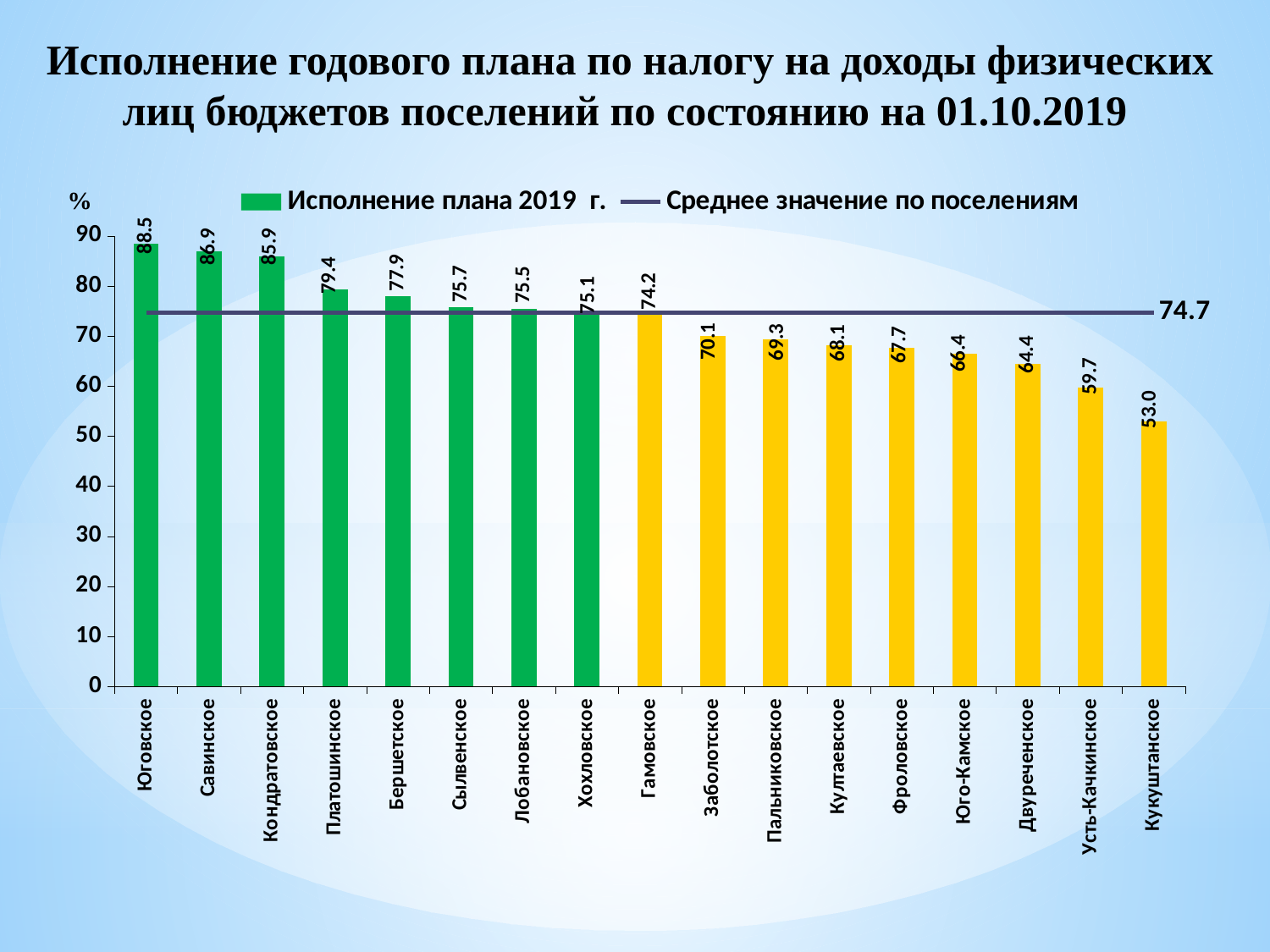
What is the value of the average line (Среднее значение по поселениям)? 74.7 Is the value for Усть-Качкинское greater or less than 60? less What is the value for Кукуштанское? 53.0 How many settlements are shown on the x axis? 17 Do the bar values rise or fall from left to right along the x axis? fall What kind of chart is shown on the slide? combination bar and line chart What is the difference between the values for Юговское and Кукуштанское? 35.5 Which is larger, the value for Гамовское or the value for Заболотское? Гамовское How many entries does the legend list? 2 Which settlement has the lowest value? Кукуштанское Which settlement has the highest value? Юговское What is the value for Платошинское? 79.4